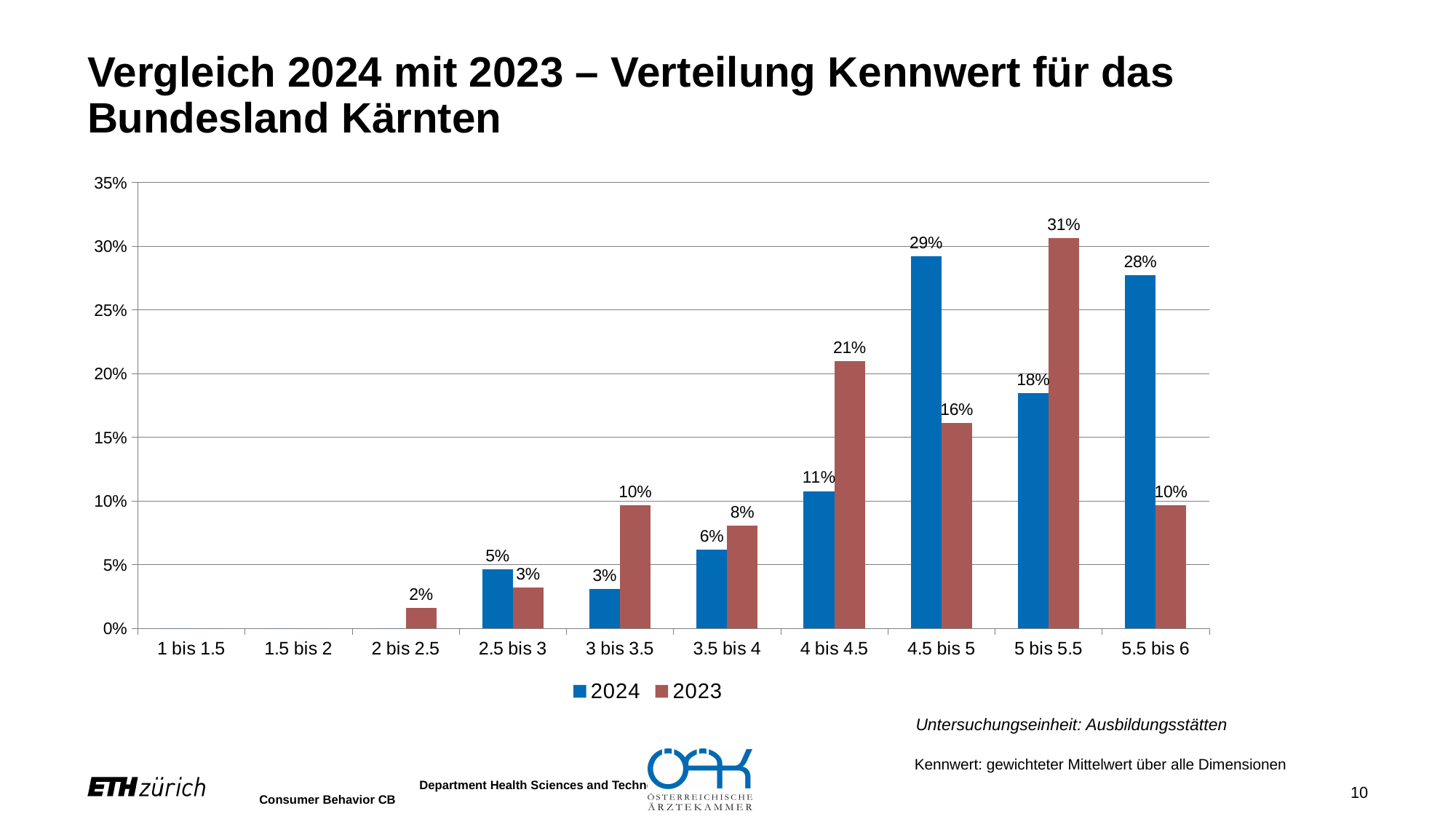
What is the value for 2023 in the category 5 bis 5.5? 31% How many series does the legend list? 2 Which category has the highest value for the 2024 series? 4.5 bis 5 What kind of chart is shown on the slide? bar chart Which series is shown in blue according to the legend? 2024 What is the value for 2024 in the category 5.5 bis 6? 28% What is the value for 2024 in the category 4.5 bis 5? 29% In the category 4 bis 4.5, which series has the larger value, 2024 or 2023? 2023 What is the difference between the 2024 and 2023 values in the category 5.5 bis 6? 18% What is the value for 2023 in the category 2 bis 2.5? 2% Which category has the highest value for the 2023 series? 5 bis 5.5 How many categories are shown on the x axis? 10